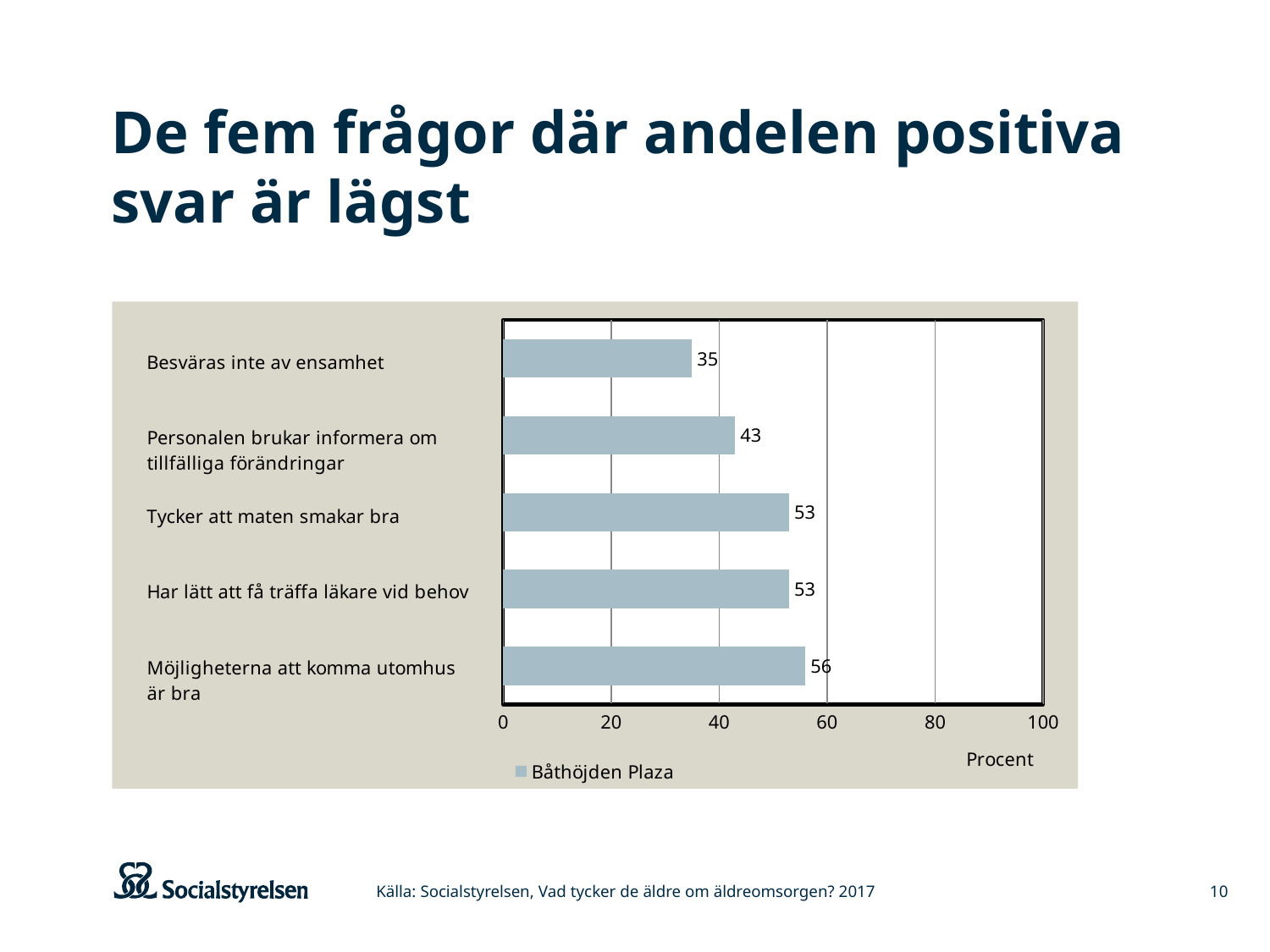
What is the value for "Möjligheterna att komma utomhus är bra"? 56 What is the value for "Personalen brukar informera om tillfälliga förändringar"? 43 Which is larger, the value for "Personalen brukar informera om tillfälliga förändringar" or the value for "Har lätt att få träffa läkare vid behov"? Har lätt att få träffa läkare vid behov What kind of chart is shown on the slide? bar chart Is the value for "Besväras inte av ensamhet" greater or less than 40? less Which category has the lowest value? Besväras inte av ensamhet What is the value for "Besväras inte av ensamhet"? 35 Which category has the highest value? Möjligheterna att komma utomhus är bra What is the difference between the values for "Möjligheterna att komma utomhus är bra" and "Besväras inte av ensamhet"? 21 How many categories are shown in the chart? 5 What is the value for "Tycker att maten smakar bra"? 53 What series name does the legend show? Båthöjden Plaza